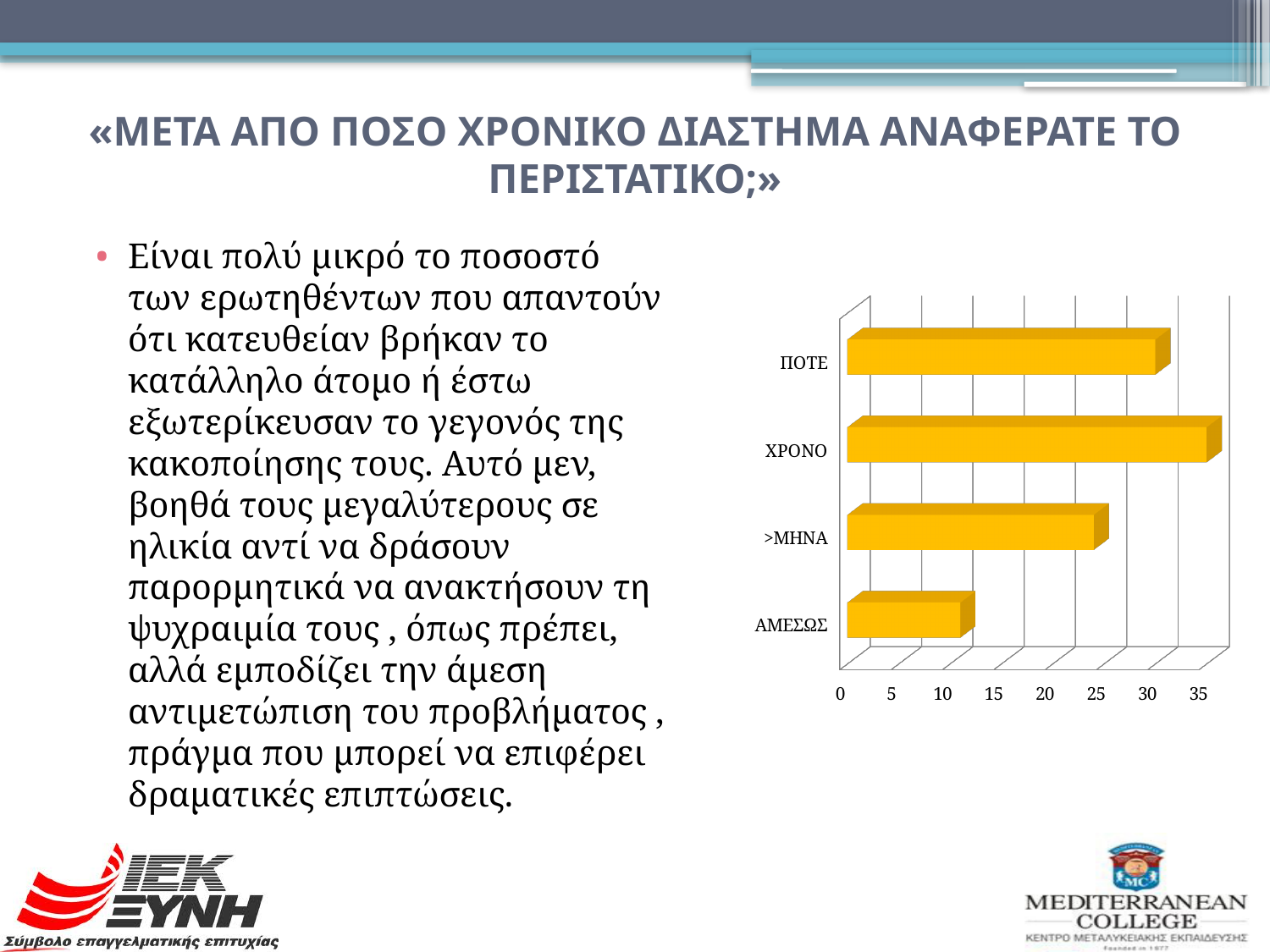
Is the value for ΧΡΟΝΟ greater or less than 30? greater Is the value for ΑΜΕΣΩΣ greater or less than 15? less Which is larger, the value for ΠΟΤΕ or the value for >ΜΗΝΑ? ΠΟΤΕ How many categories does the chart show? 4 What colour are the bars in the chart? yellow Is the value for >ΜΗΝΑ greater or less than 30? less What kind of chart is shown on the slide? bar chart Which is larger, the value for ΧΡΟΝΟ or the value for ΑΜΕΣΩΣ? ΧΡΟΝΟ Which category has the highest value in the chart? ΧΡΟΝΟ Which is larger, the value for ΠΟΤΕ or the value for ΧΡΟΝΟ? ΧΡΟΝΟ Which category has the lowest value in the chart? ΑΜΕΣΩΣ